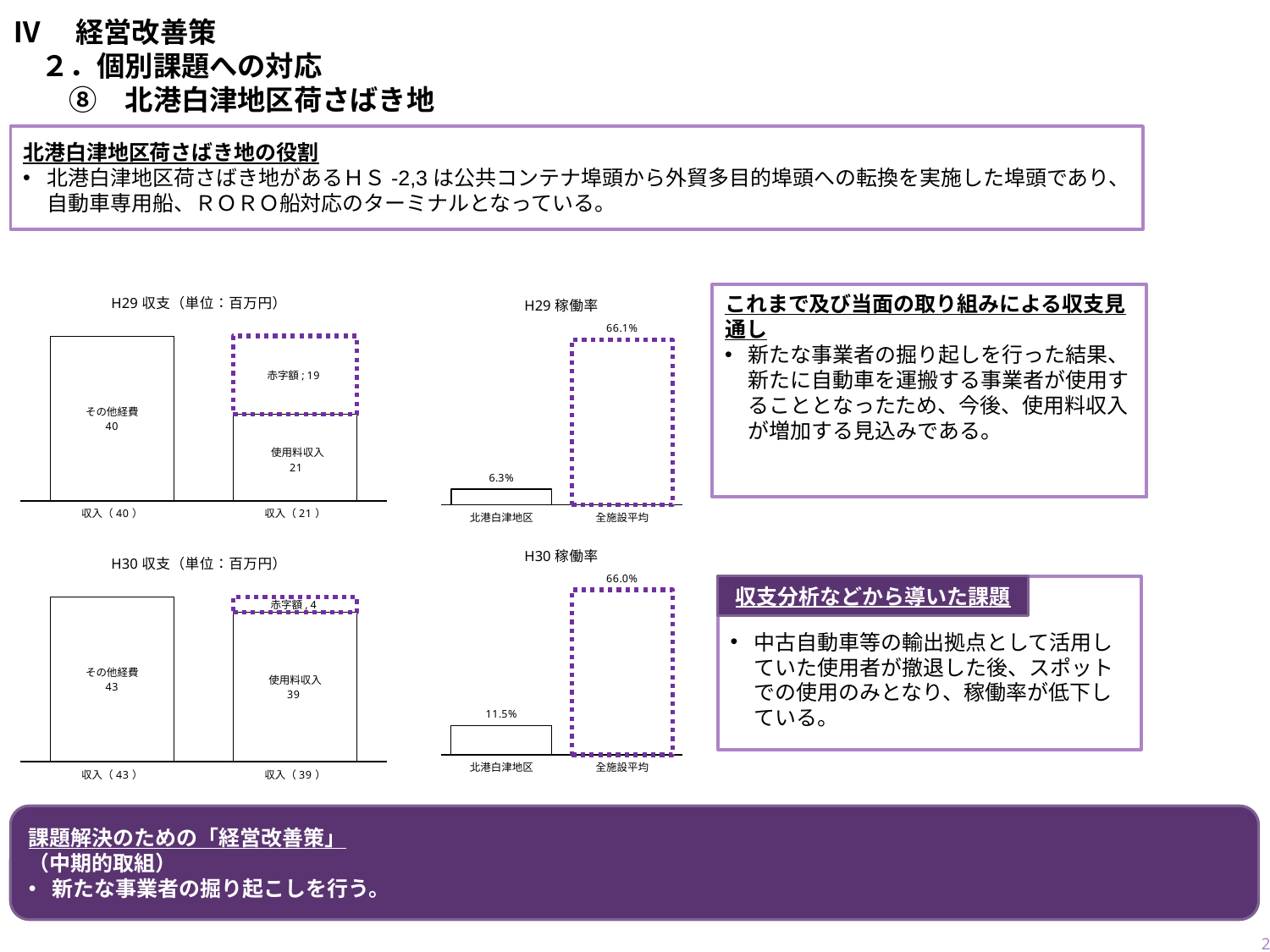
「H30 稼働率」のグラフで、北港白津地区の稼働率は何%ですか。 11.5% 「H29 収支」のグラフで、使用料収入の値はいくらですか。 21 「H29 稼働率」のグラフで、全施設平均の稼働率は何%ですか。 66.1% 「H29 収支」のグラフで、その他経費の値はいくらですか。 40 「H30 稼働率」のグラフで、全施設平均と北港白津地区の稼働率の差は何ポイントですか。 54.5ポイント 「H29 稼働率」のグラフはどの種類のグラフですか。 棒グラフ 「H29 収支」のグラフで、赤字額と使用料収入を合計するといくらになりますか。 40 「H29 稼働率」のグラフで、北港白津地区の稼働率は何%ですか。 6.3% 「H30 収支」のグラフで、使用料収入の値はいくらですか。 39 「H29 収支」のグラフで、赤字額の値はいくらですか。 19 「H30 稼働率」のグラフで、北港白津地区と全施設平均ではどちらの稼働率が高いですか。 全施設平均 「H30 収支」のグラフで、その他経費と使用料収入の差はいくらですか。 4